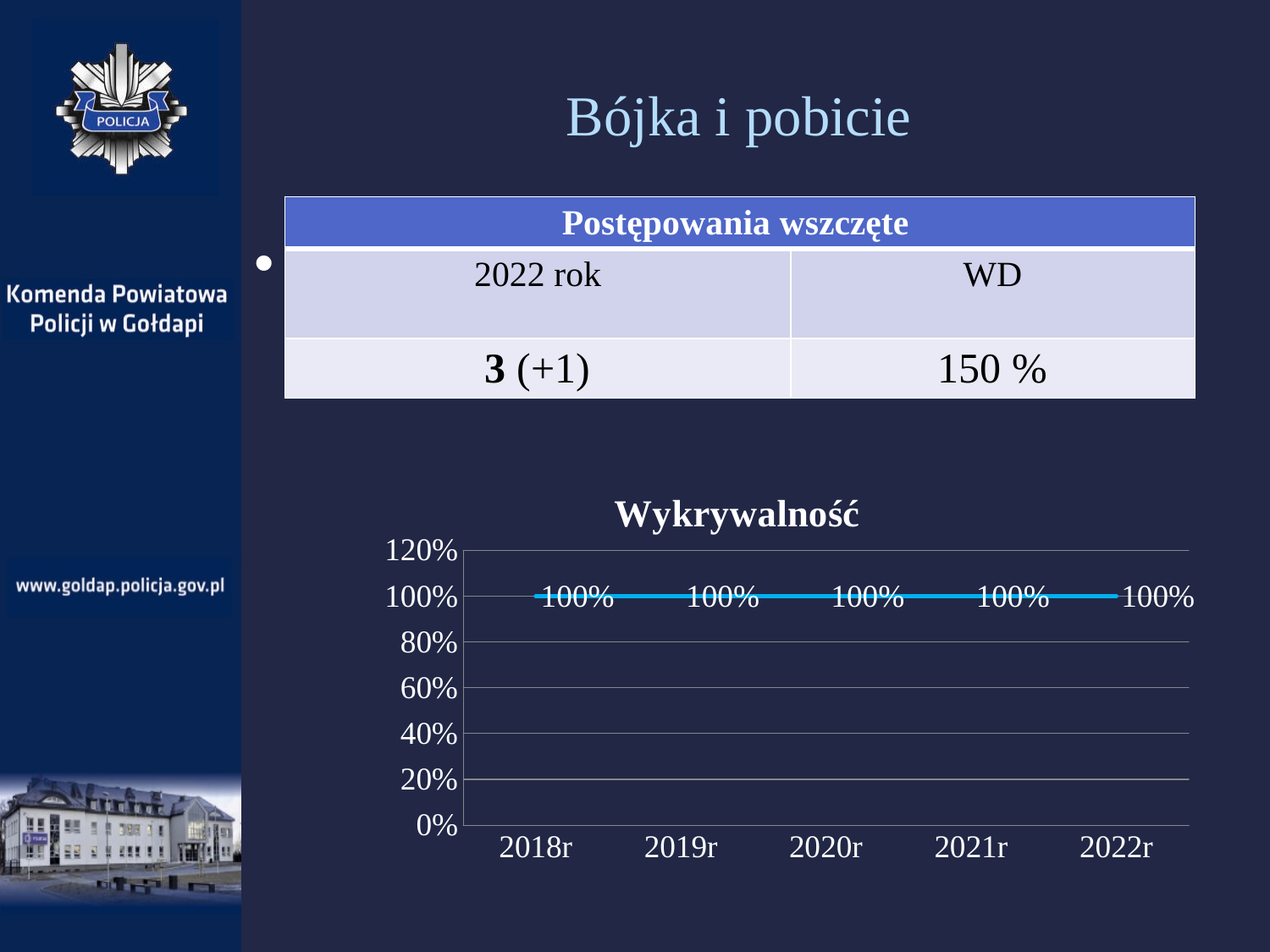
What is the value for 2018r in the Wykrywalność chart? 100% What is the highest value shown on the y axis of the Wykrywalność chart? 120% Is the value for 2021r in the Wykrywalność chart greater or less than 80%? greater What kind of chart is the Wykrywalność chart? line chart How many years are plotted on the x axis of the Wykrywalność chart? 5 What is the difference between the values for 2019r and 2021r in the Wykrywalność chart? 0% What is the title of the chart on the slide? Wykrywalność Is the value for 2019r in the Wykrywalność chart greater or less than 120%? less Do the values in the Wykrywalność chart rise, fall or stay the same from 2018r to 2022r? stay the same What is the value for 2022r in the Wykrywalność chart? 100% Which year is the first category on the x axis of the Wykrywalność chart? 2018r What is the value for 2020r in the Wykrywalność chart? 100%